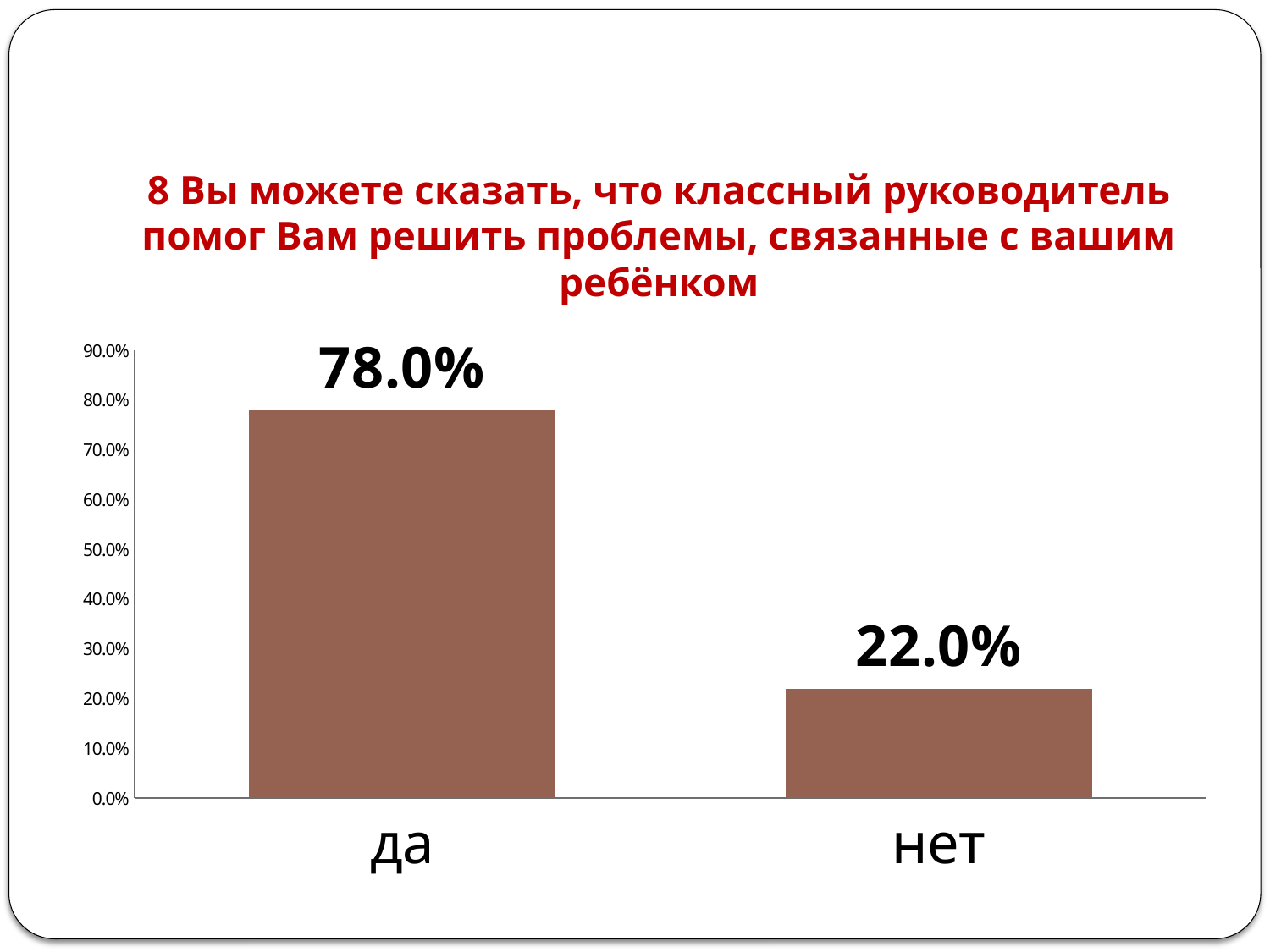
What is the highest value shown on the vertical axis? 90.0% What is the value for "нет"? 22.0% Is the value for "нет" greater or less than 30.0%? less What is the value for "да"? 78.0% Is the value for "да" greater or less than 70.0%? greater What kind of chart is shown on the slide? bar chart What is the difference between the values for "да" and "нет"? 56.0% Which category has the highest value? да Which category has the lowest value? нет What is the total of the two values shown? 100.0% How many categories are shown on the x axis? 2 Which is larger, the value for "да" or the value for "нет"? да